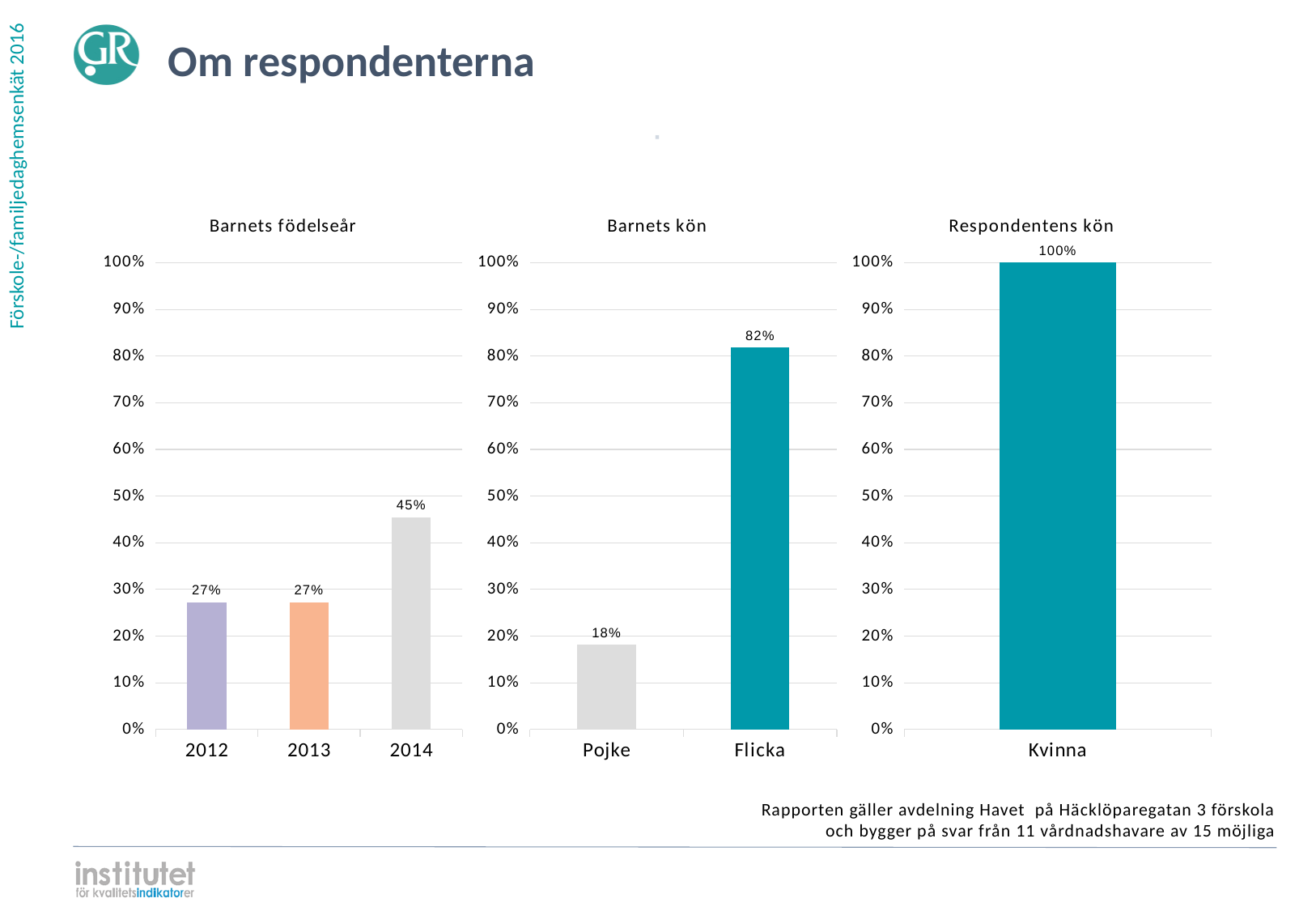
In the 'Barnets födelseår' chart, which year has the highest value? 2014 In the 'Respondentens kön' chart, what is the value for Kvinna? 100% In the 'Barnets kön' chart, what is the difference between Flicka and Pojke? 64% In the 'Barnets kön' chart, what is the value for Pojke? 18% In the 'Barnets födelseår' chart, what is the difference between the values for 2014 and 2013? 18% In the 'Barnets kön' chart, what is the value for Flicka? 82% In the 'Barnets födelseår' chart, what is the value for 2012? 27% What kind of chart is the 'Barnets kön' chart? Bar chart In the 'Respondentens kön' chart, how many categories are shown on the x axis? 1 In the 'Barnets födelseår' chart, what is the value for 2014? 45% In the 'Barnets födelseår' chart, how many categories are shown on the x axis? 3 In the 'Barnets kön' chart, which category has the lowest value? Pojke